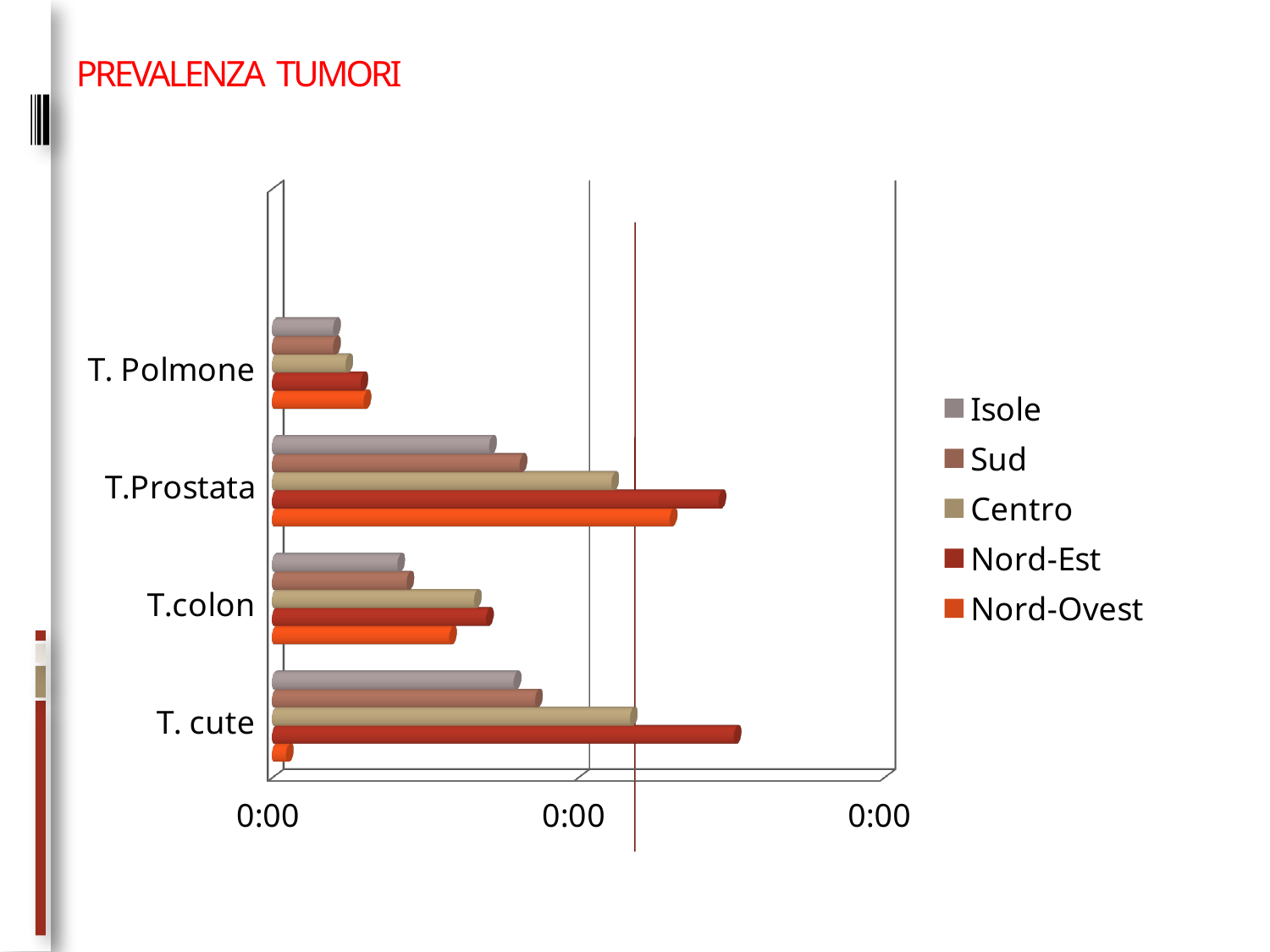
What type of chart is shown on the slide? bar chart How many categories (tumour types) are shown on the chart? 4 Which tumour type has the shortest bars overall across all regions? T. Polmone For T.colon, which region has the highest value? Nord-Est What is the title of the slide? PREVALENZA TUMORI For T.Prostata, which region has the highest value? Nord-Est For T. cute, which region has the lowest value? Nord-Ovest How many series does the legend list? 5 For T. cute, which region has the highest value? Nord-Est For T.Prostata, which is larger: the Centro value or the Nord-Ovest value? Nord-Ovest For T.Prostata, which region has the lowest value? Isole Which series is shown in orange in the legend? Nord-Ovest